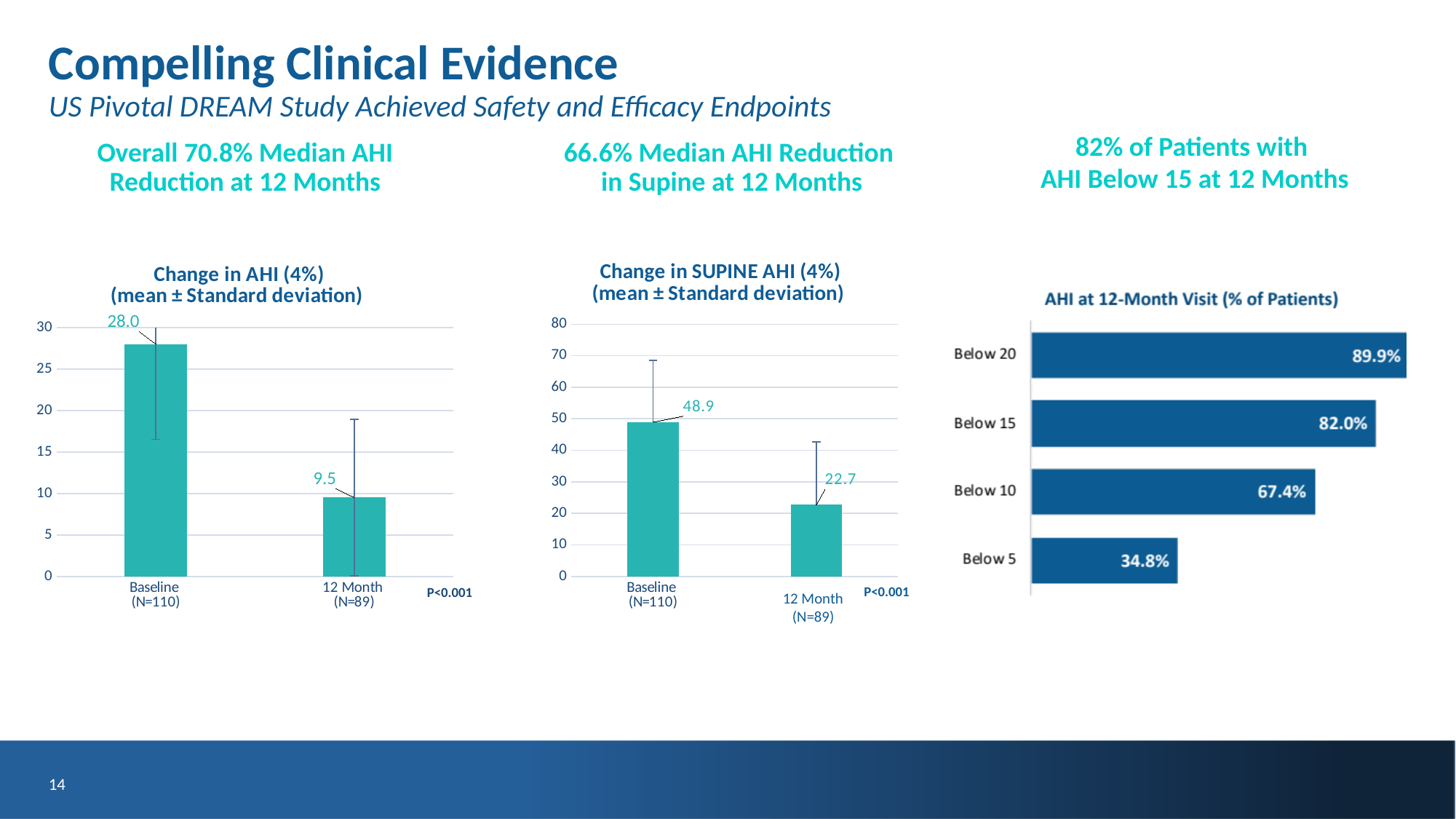
In the 'Change in SUPINE AHI (4%)' chart, what is the value for 12 Month (N=89)? 22.7 In the 'Change in AHI (4%)' chart, what is the value for Baseline (N=110)? 28.0 In the 'Change in SUPINE AHI (4%)' chart, do the values rise or fall from Baseline to 12 Month? fall In the 'Change in SUPINE AHI (4%)' chart, what is the value for Baseline (N=110)? 48.9 In the 'Change in SUPINE AHI (4%)' chart, which is larger, the Baseline value or the 12 Month value? Baseline What kind of chart is the 'AHI at 12-Month Visit (% of Patients)' chart? bar chart In the 'AHI at 12-Month Visit (% of Patients)' chart, which category has the highest value? Below 20 In the 'AHI at 12-Month Visit (% of Patients)' chart, how many categories are shown? 4 In the 'Change in AHI (4%)' chart, what is the difference between the Baseline and 12 Month values? 18.5 In the 'Change in AHI (4%)' chart, what is the value for 12 Month (N=89)? 9.5 In the 'AHI at 12-Month Visit (% of Patients)' chart, which category has the lowest value? Below 5 In the 'AHI at 12-Month Visit (% of Patients)' chart, what is the value for Below 15? 82.0%